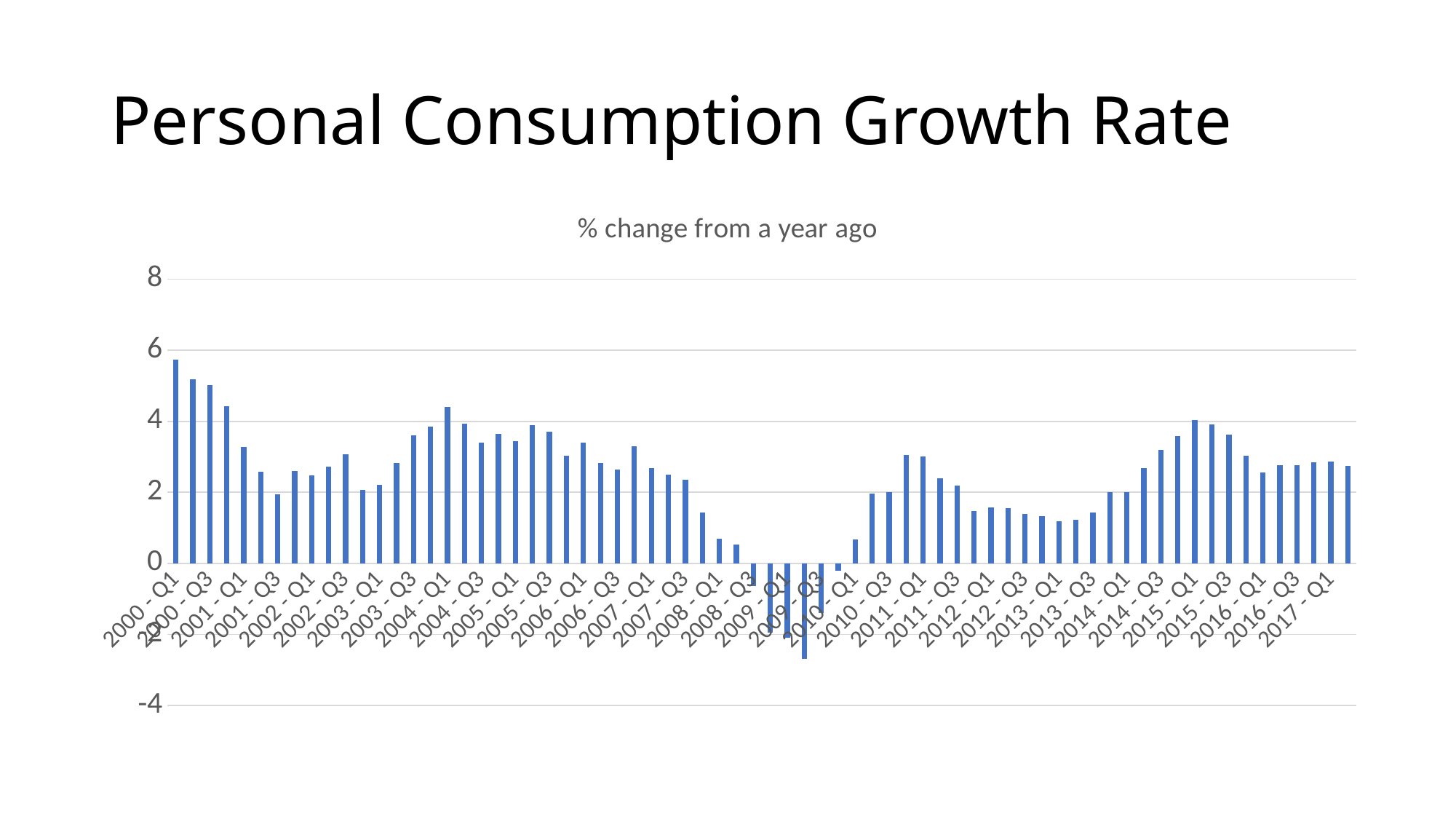
Is the value for 2000 - Q1 greater or less than 4? greater What is the subtitle shown above the chart's plot area? % change from a year ago Which is larger, the value for 2004 - Q1 or the value for 2013 - Q1? 2004 - Q1 Do the values rise or fall from 2000 - Q1 to 2002 - Q1? fall Is the value for 2008 - Q3 greater or less than 2? less Is the value for 2009 - Q1 greater or less than 0? less Which quarter has the highest personal consumption growth rate? 2000 - Q1 Which is larger, the value for 2000 - Q1 or the value for 2017 - Q1? 2000 - Q1 What kind of chart is shown on the slide? bar chart Which quarter has the lowest personal consumption growth rate? 2009 - Q2